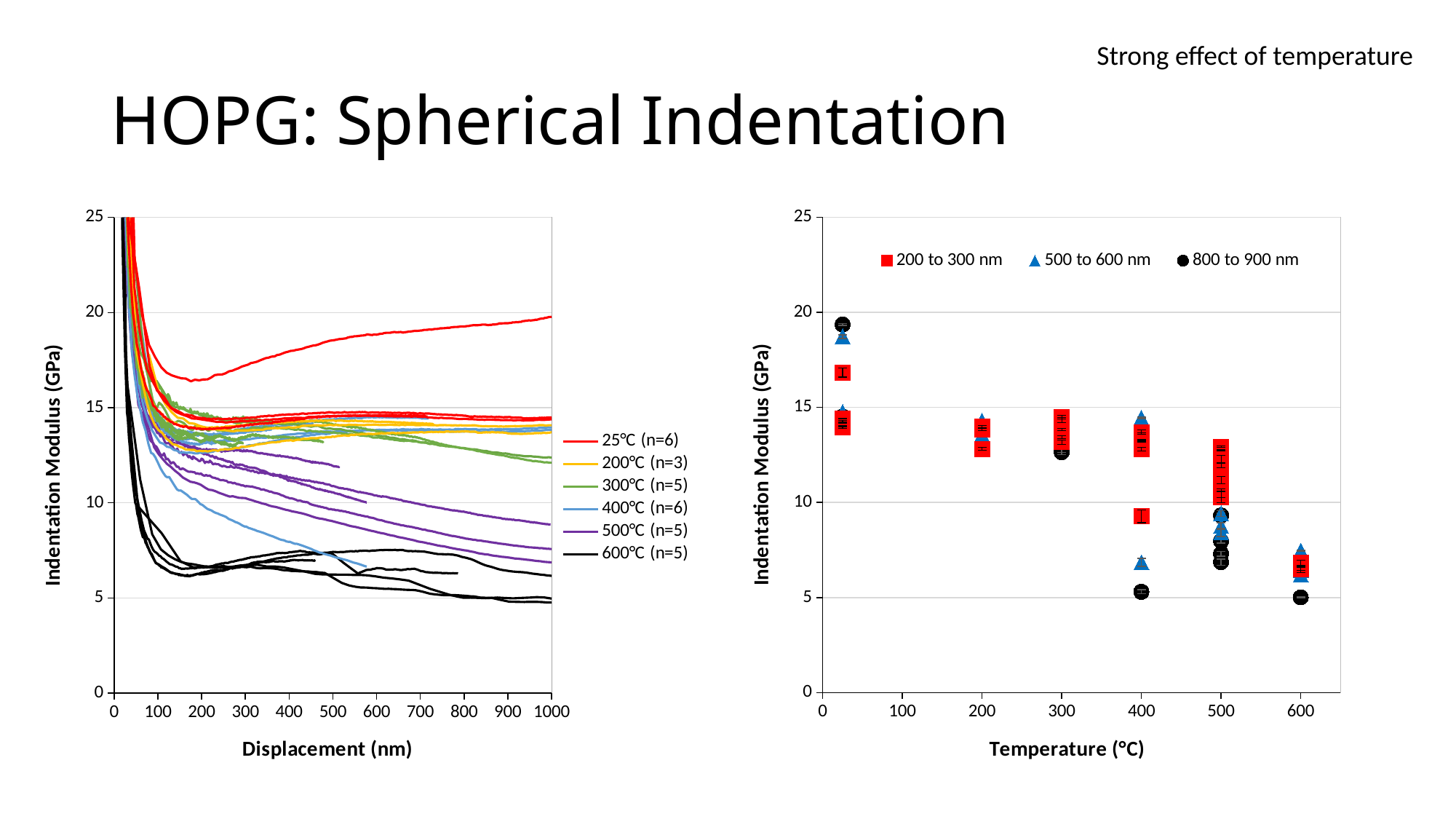
How many series does the legend of the right chart list? 3 On the right chart, which series has the lowest indentation modulus at 400°C? 800 to 900 nm On the left chart, is the indentation modulus of the 600°C curves at 1000 nm greater or less than 10 GPa? less How many series does the legend of the left chart list? 6 What kind of chart is the left chart (Indentation Modulus vs Displacement)? line chart On the right chart, does the indentation modulus generally rise or fall as temperature increases? fall On the left chart, which series has the lowest indentation modulus at 1000 nm displacement? 600°C (n=5) On the right chart, how many distinct temperature levels have data points plotted? 6 On the right chart, is the indentation modulus for the 800 to 900 nm series at 600°C greater or less than 10 GPa? less On the left chart, how many tests (n) are listed for the 200°C series in the legend? 3 What kind of chart is the right chart (Indentation Modulus vs Temperature)? scatter chart On the left chart, do the 500°C curves rise or fall as displacement increases from 200 nm to 1000 nm? fall